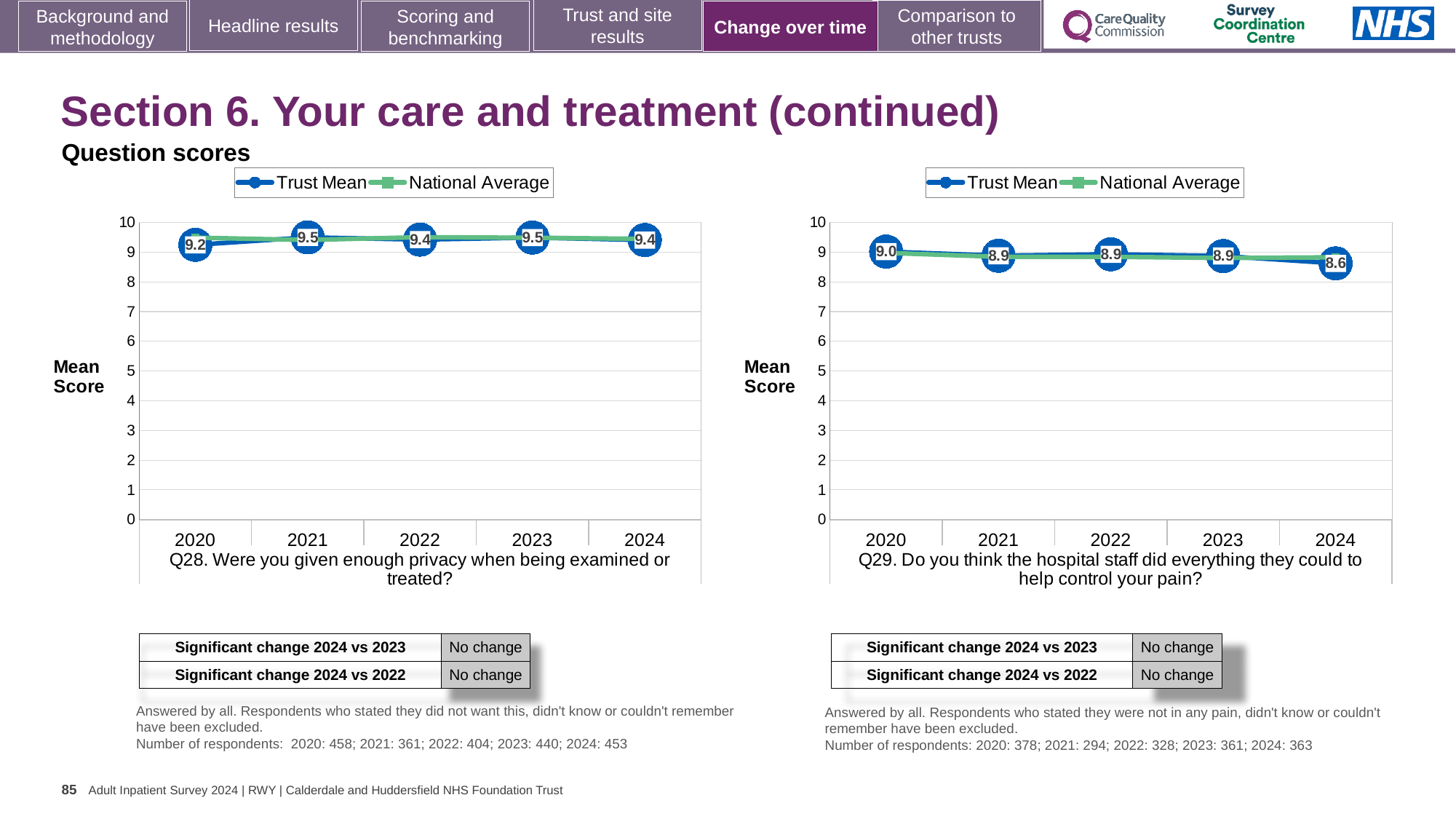
In the Q29 chart on the right, is the National Average value for 2024 greater or less than 8? greater In the Q28 chart on the left, what is the Trust Mean score for 2020? 9.2 How many series does the legend of the Q29 chart on the right list? 2 In the Q28 chart on the left, what is the difference between the Trust Mean scores for 2021 and 2020? 0.3 How many years are plotted on the x axis of the Q28 chart on the left? 5 What kind of chart is the Q28 chart on the left? Line chart In the Q29 chart on the right, what is the difference between the Trust Mean scores for 2020 and 2024? 0.4 In the Q29 chart on the right, which year has the lowest Trust Mean score? 2024 In the Q29 chart on the right, which year has the highest Trust Mean score? 2020 In the Q28 chart on the left, is the Trust Mean score higher in 2021 or in 2020? 2021 In the Q28 chart on the left, which year has the lowest Trust Mean score? 2020 In the Q29 chart on the right, what is the Trust Mean score for 2024? 8.6